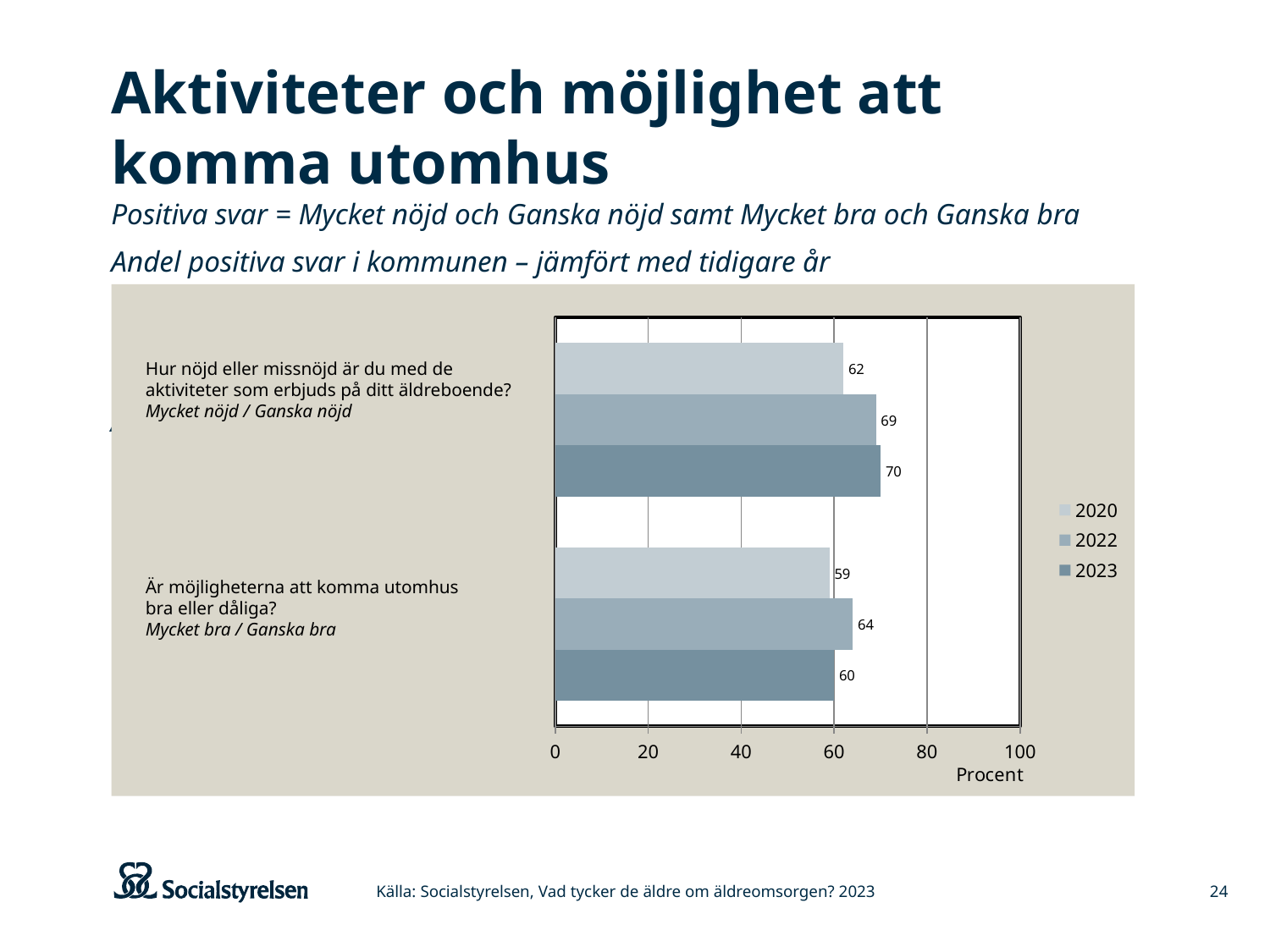
Which is larger: the 2023 value for the activities question or the 2023 value for the outdoors question? The activities question (70) Is the 2020 value for "Är möjligheterna att komma utomhus bra eller dåliga?" greater or less than 60? less What kind of chart is shown on the slide? Bar chart What is the 2023 value for "Hur nöjd eller missnöjd är du med de aktiviteter som erbjuds på ditt äldreboende?"? 70 Which year has the highest value for "Hur nöjd eller missnöjd är du med de aktiviteter som erbjuds på ditt äldreboende?"? 2023 What is the 2020 value for "Är möjligheterna att komma utomhus bra eller dåliga?"? 59 What is the 2022 value for "Är möjligheterna att komma utomhus bra eller dåliga?"? 64 What is the difference between the 2022 and 2020 values for "Hur nöjd eller missnöjd är du med de aktiviteter som erbjuds på ditt äldreboende?"? 7 How many series does the legend list? 3 Which year has the lowest value for "Är möjligheterna att komma utomhus bra eller dåliga?"? 2020 What is the difference between the 2022 and 2023 values for "Är möjligheterna att komma utomhus bra eller dåliga?"? 4 What is the label on the x axis of the chart? Procent